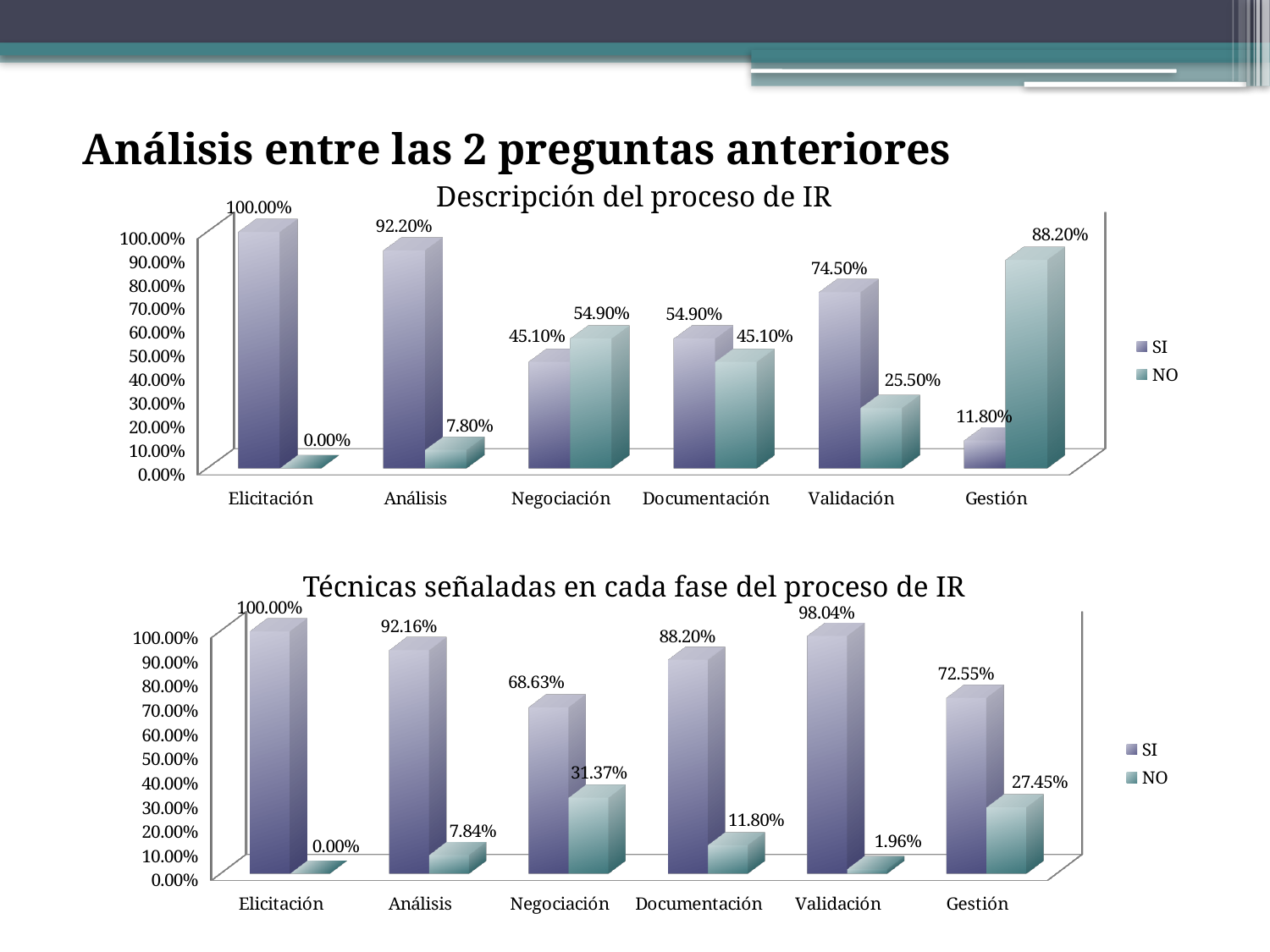
In the 'Descripción del proceso de IR' chart, which is larger for Negociación, SI or NO? NO In the 'Descripción del proceso de IR' chart, what is the NO value for Gestión? 88.20% In the 'Técnicas señaladas en cada fase del proceso de IR' chart, what is the difference between the SI values for Documentación and Gestión? 15.65% In the 'Descripción del proceso de IR' chart, how many categories are shown on the x axis? 6 In the 'Descripción del proceso de IR' chart, what is the SI value for Validación? 74.50% In the 'Técnicas señaladas en cada fase del proceso de IR' chart, what is the NO value for Validación? 1.96% In the 'Descripción del proceso de IR' chart, which category has the lowest SI value? Gestión What type of chart is the 'Descripción del proceso de IR' chart? Bar chart How many series does the legend of the 'Técnicas señaladas en cada fase del proceso de IR' chart list? 2 In the 'Técnicas señaladas en cada fase del proceso de IR' chart, which category has the highest NO value? Negociación In the 'Técnicas señaladas en cada fase del proceso de IR' chart, what is the SI value for Negociación? 68.63% In the 'Descripción del proceso de IR' chart, what is the difference between the SI and NO values for Validación? 49.00%